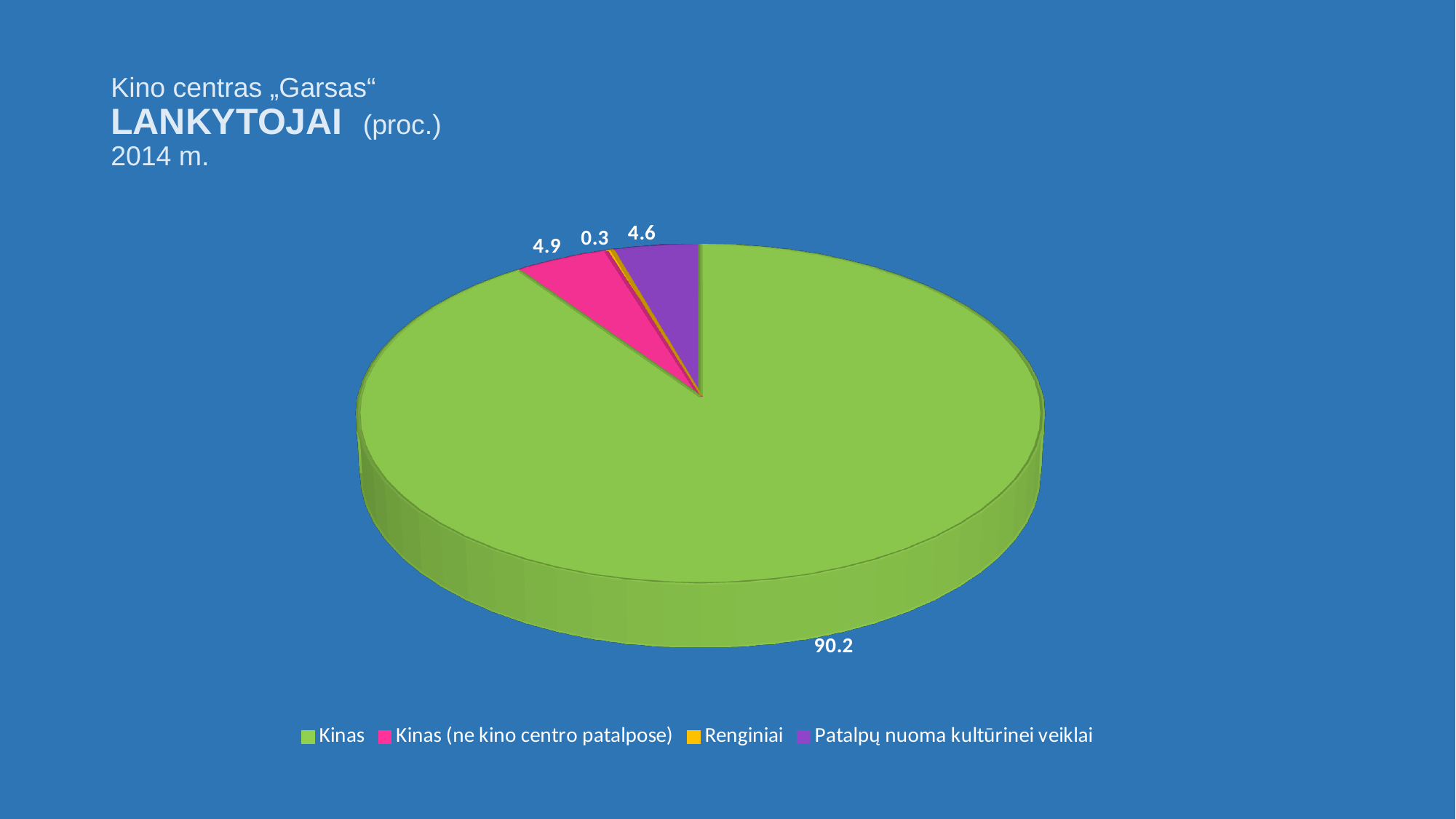
What is the value for Patalpų nuoma kultūrinei veiklai? 4.6 What colour is the slice for Patalpų nuoma kultūrinei veiklai? Purple What is the value for Kinas (ne kino centro patalpose)? 4.9 What is the value for Renginiai? 0.3 What is the difference between the values for Kinas (ne kino centro patalpose) and Patalpų nuoma kultūrinei veiklai? 0.3 Which category has the largest slice? Kinas How many categories does the legend list? 4 What is the difference between the values for Kinas and Kinas (ne kino centro patalpose)? 85.3 Which category has the smallest slice? Renginiai What type of chart is shown on the slide? Pie chart What is the value for Kinas? 90.2 Which is larger, the value for Kinas (ne kino centro patalpose) or the value for Renginiai? Kinas (ne kino centro patalpose)